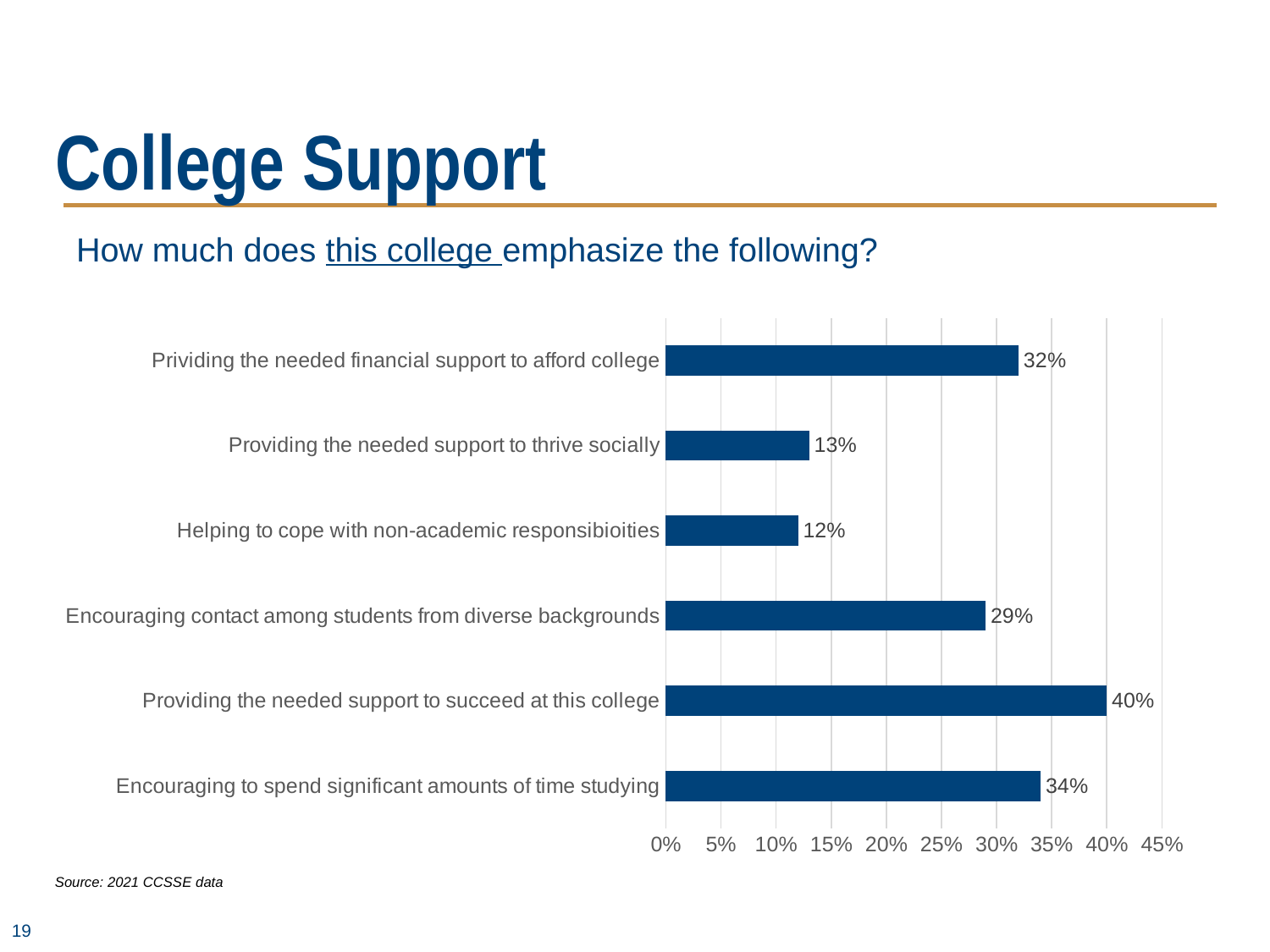
What is the value for 'Encouraging contact among students from diverse backgrounds'? 29% What is the value for 'Providing the needed support to thrive socially'? 13% Is the value for 'Encouraging to spend significant amounts of time studying' greater or less than 30%? greater Which is larger: the value for 'Prividing the needed financial support to afford college' or the value for 'Encouraging contact among students from diverse backgrounds'? Prividing the needed financial support to afford college Which category has the highest value? Providing the needed support to succeed at this college Which category has the lowest value? Helping to cope with non-academic responsibioities What is the difference between the values for 'Providing the needed support to thrive socially' and 'Helping to cope with non-academic responsibioities'? 1% What is the difference between the values for 'Providing the needed support to succeed at this college' and 'Encouraging to spend significant amounts of time studying'? 6% How many categories are shown in the chart? 6 What is the source cited for the chart data? 2021 CCSSE data What kind of chart is shown on the slide? bar chart What is the value for 'Providing the needed support to succeed at this college'? 40%